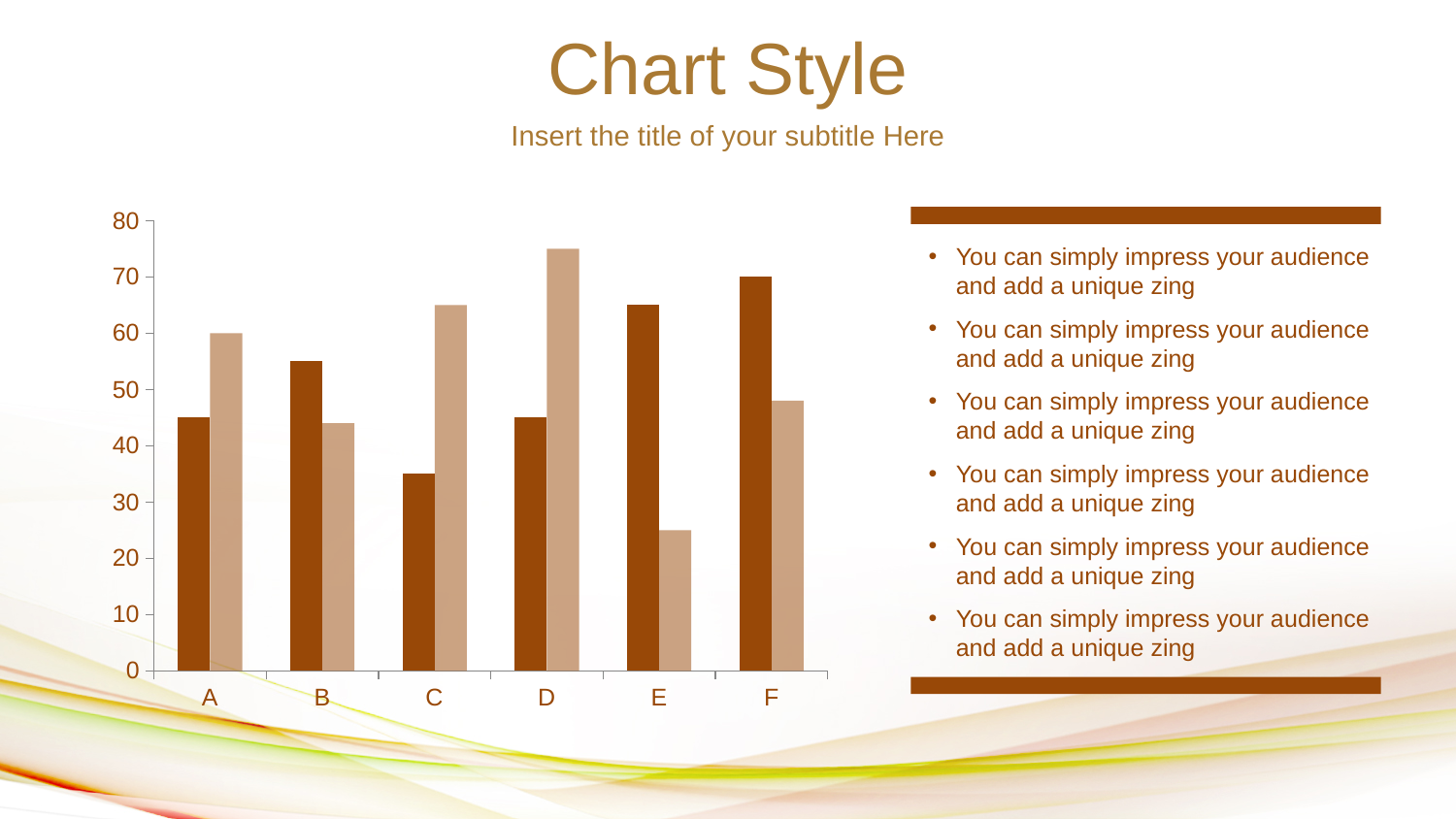
What kind of chart is shown on the slide? bar chart Which category has the tallest light tan bar? D How many bars are plotted for each category in the chart? 2 How many categories are shown on the x axis of the chart? 6 Is the value of the dark brown bar for E greater or less than 60? greater Is the value of the light tan bar for E greater or less than 30? less Which category has the shortest light tan bar? E Which category has the shortest dark brown bar? C Which category has the tallest dark brown bar? F Is the value of the light tan bar for D greater or less than 70? greater For category C, which bar is taller, the dark brown bar or the light tan bar? light tan For category E, which bar is taller, the dark brown bar or the light tan bar? dark brown